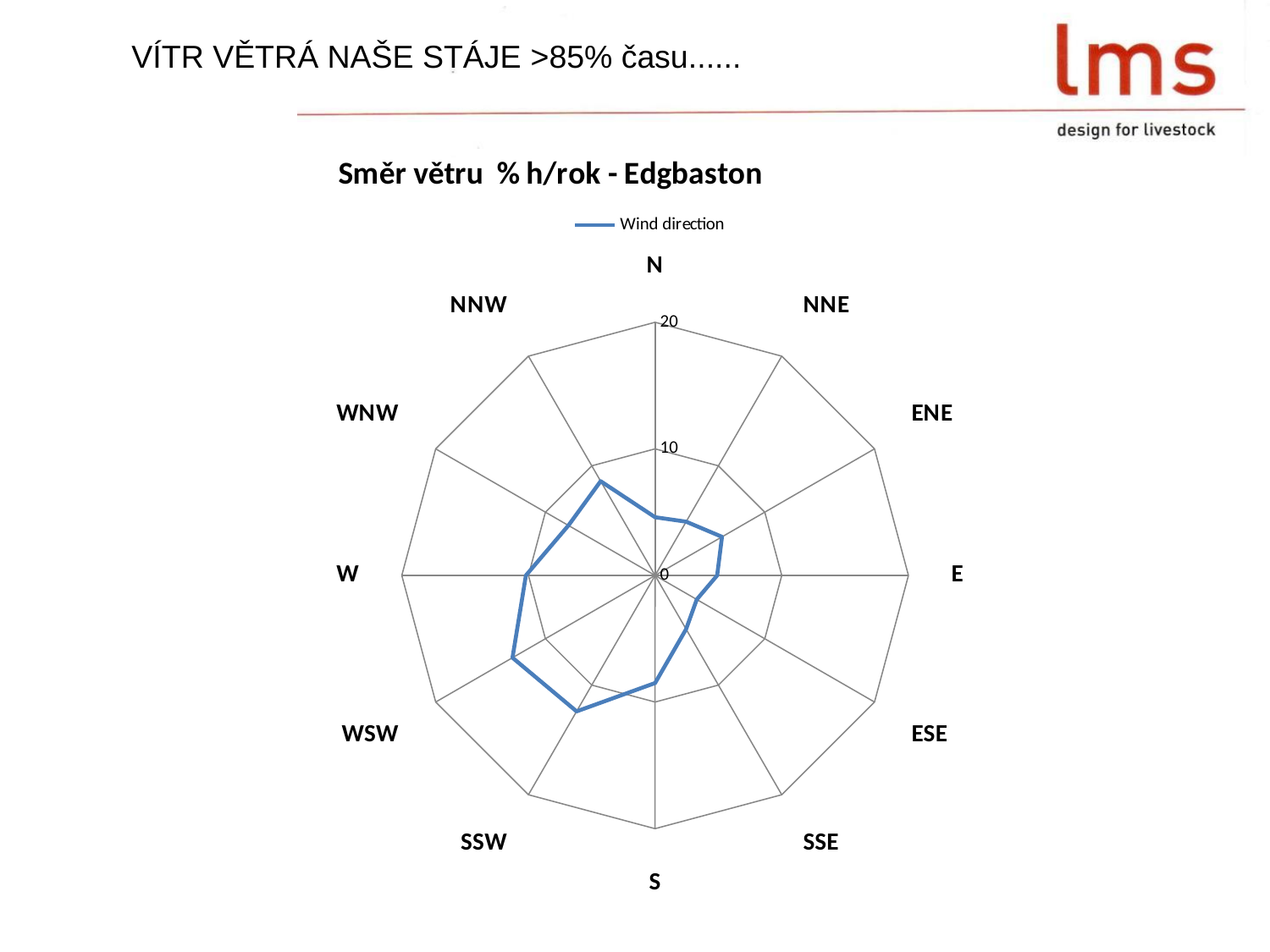
Is the value for N greater or less than 10? less Is the value for E greater or less than 10? less How many series does the legend list? 1 What kind of chart is shown on the slide? Radar chart How many wind direction categories are plotted on the chart? 12 Which has the larger value, WSW or N? WSW Which has the larger value, SSW or E? SSW Is the value for S greater or less than 10? less What is the name of the series shown in the legend? Wind direction What is the title of the chart? Směr větru % h/rok - Edgbaston